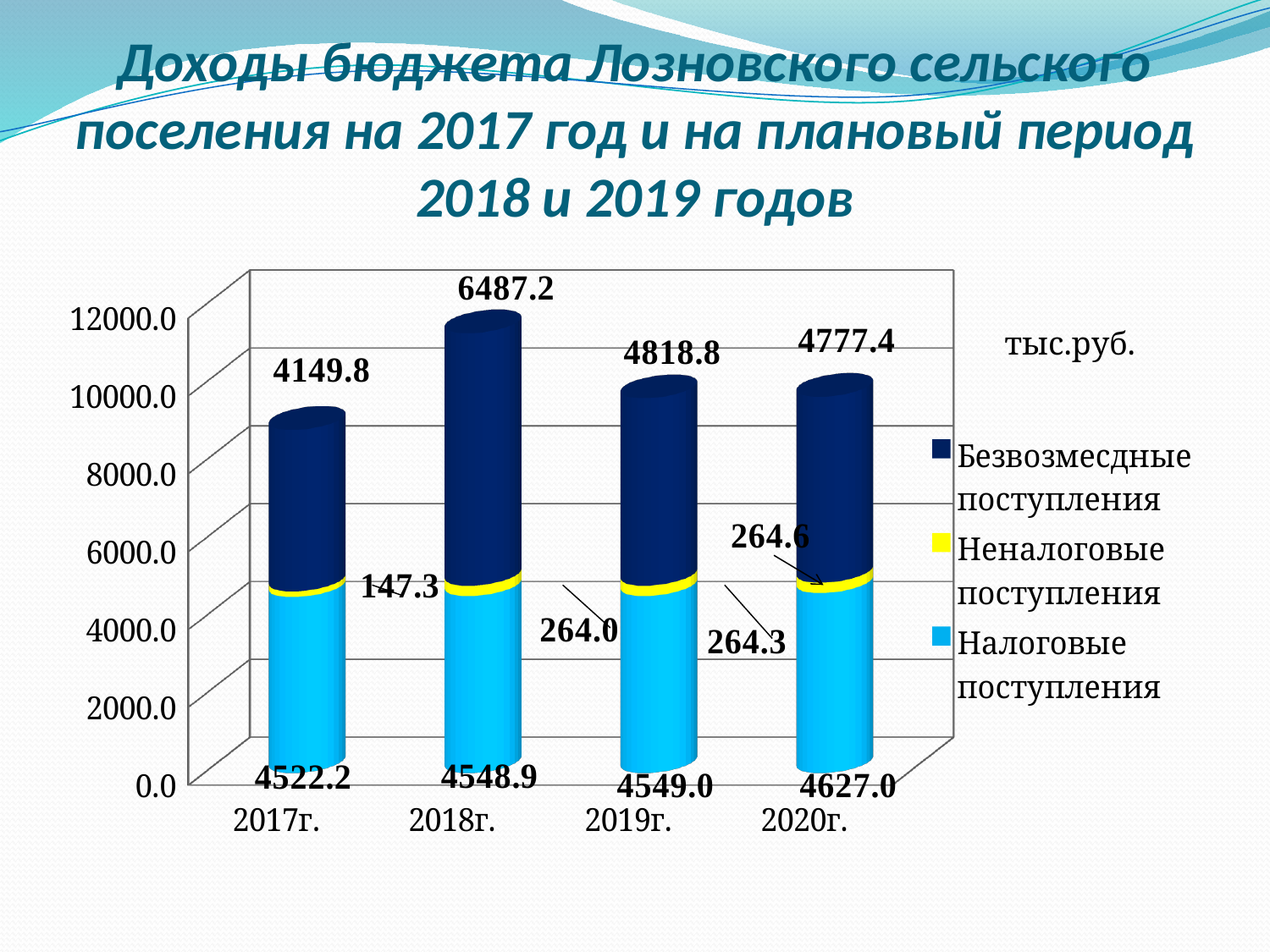
Which is larger, Налоговые поступления in 2017г. or in 2020г.? 2020г. What kind of chart is shown on the slide? bar chart How many years are shown on the x axis? 4 What is the value of Налоговые поступления for 2020г.? 4627.0 What is the difference between Безвозмездные поступления in 2019г. and 2020г.? 41.4 Do Налоговые поступления rise or fall from 2017г. to 2020г.? rise What unit of measurement is shown next to the chart? тыс.руб. In which year are Налоговые поступления the lowest? 2017г. In which year are Безвозмездные поступления the highest? 2018г. What is the value of Неналоговые поступления for 2020г.? 264.6 What is the value of Безвозмездные поступления for 2018г.? 6487.2 How many series does the legend list? 3